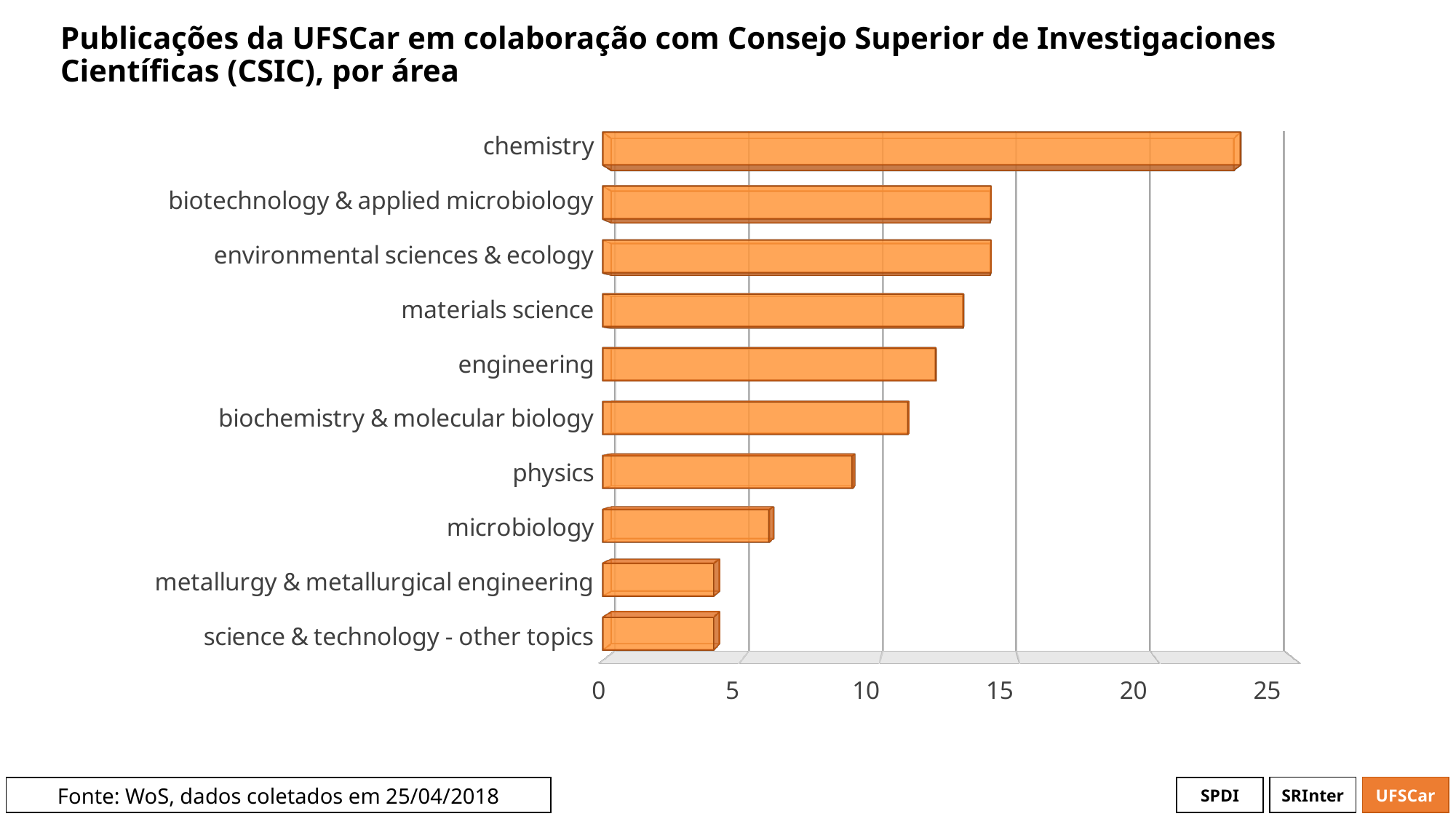
Which is larger, the value for chemistry or the value for physics? chemistry Is the value for microbiology greater or less than 5? greater Is the value for metallurgy & metallurgical engineering greater or less than 5? less Which area has the highest number of publications? chemistry What kind of chart is shown on the slide? bar chart Is the value for materials science greater or less than 15? less Which is larger, the value for biochemistry & molecular biology or the value for microbiology? biochemistry & molecular biology What is the source of the data cited on the slide? WoS, dados coletados em 25/04/2018 How many areas (categories) are plotted in the chart? 10